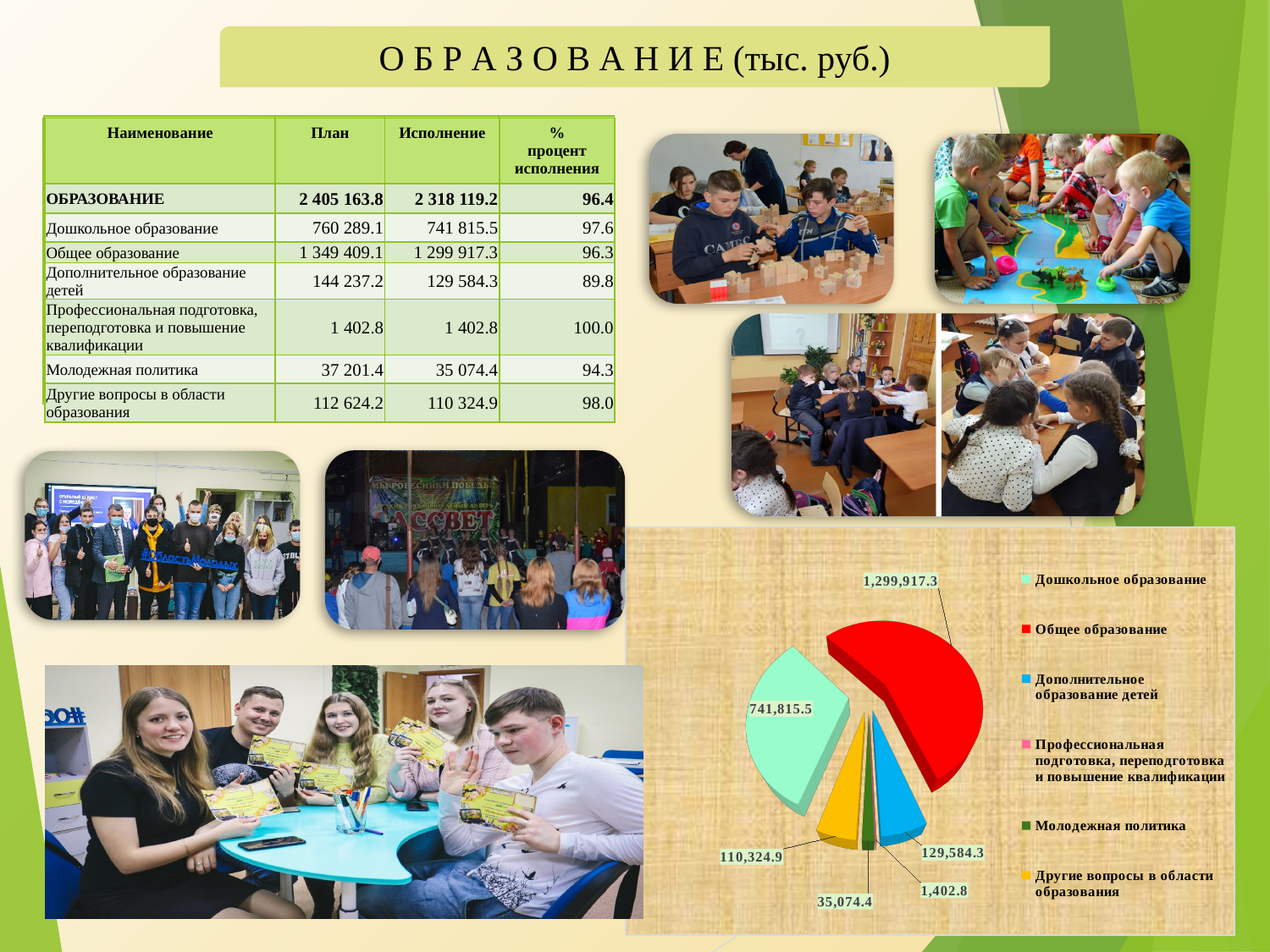
In the pie chart, which is larger: Дополнительное образование детей or Другие вопросы в области образования? Дополнительное образование детей What type of chart is shown at the bottom right of the slide? Pie chart In the pie chart, what is the value for Дополнительное образование детей? 129,584.3 Which category has the largest slice in the pie chart? Общее образование What colour is the slice for Общее образование in the pie chart? Red In the pie chart, what is the value for Молодежная политика? 35,074.4 In the pie chart, what is the difference between the values for Общее образование and Дошкольное образование? 558,101.8 In the pie chart, what is the value for Дошкольное образование? 741,815.5 In the pie chart, what is the value for Общее образование? 1,299,917.3 Which category has the smallest slice in the pie chart? Профессиональная подготовка, переподготовка и повышение квалификации In the pie chart, what is the value for Другие вопросы в области образования? 110,324.9 How many categories does the pie chart legend list? 6